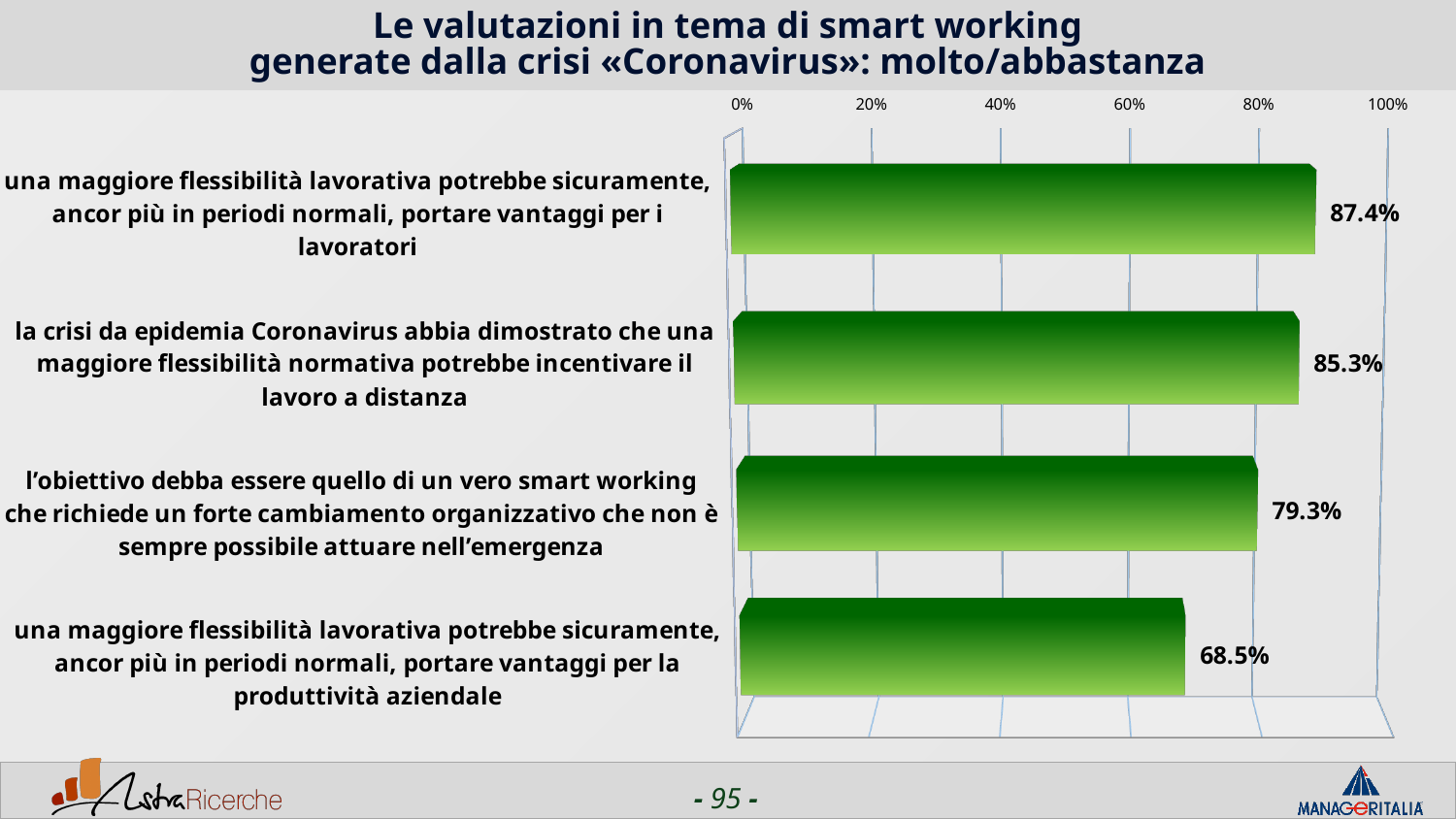
What is the difference in percentage points between the highest value (87.4%) and the lowest value (68.5%)? 18.9 What is the difference between the value for "incentivare il lavoro a distanza" (85.3%) and the value for "un vero smart working" (79.3%)? 6.0 How many statements (bars) are shown on the chart? 4 What type of chart is shown on the slide? bar chart Which statement has the highest percentage on the chart? una maggiore flessibilità lavorativa potrebbe sicuramente, ancor più in periodi normali, portare vantaggi per i lavoratori Is the value for the statement about "produttività aziendale" greater or less than 80%? less What percentage is shown for the statement that greater work flexibility could bring advantages for company productivity ("produttività aziendale")? 68.5% Which is larger: the value for advantages for workers ("vantaggi per i lavoratori") or the value for advantages for company productivity ("produttività aziendale")? vantaggi per i lavoratori Which statement has the lowest percentage on the chart? una maggiore flessibilità lavorativa potrebbe sicuramente, ancor più in periodi normali, portare vantaggi per la produttività aziendale What is the value for the statement that the Coronavirus crisis showed that greater regulatory flexibility could encourage remote work ("incentivare il lavoro a distanza")? 85.3% What value is shown for the statement that the goal should be a true smart working requiring strong organizational change ("un vero smart working")? 79.3% What percentage of respondents agree (molto/abbastanza) that greater work flexibility could bring advantages for workers ("vantaggi per i lavoratori")? 87.4%